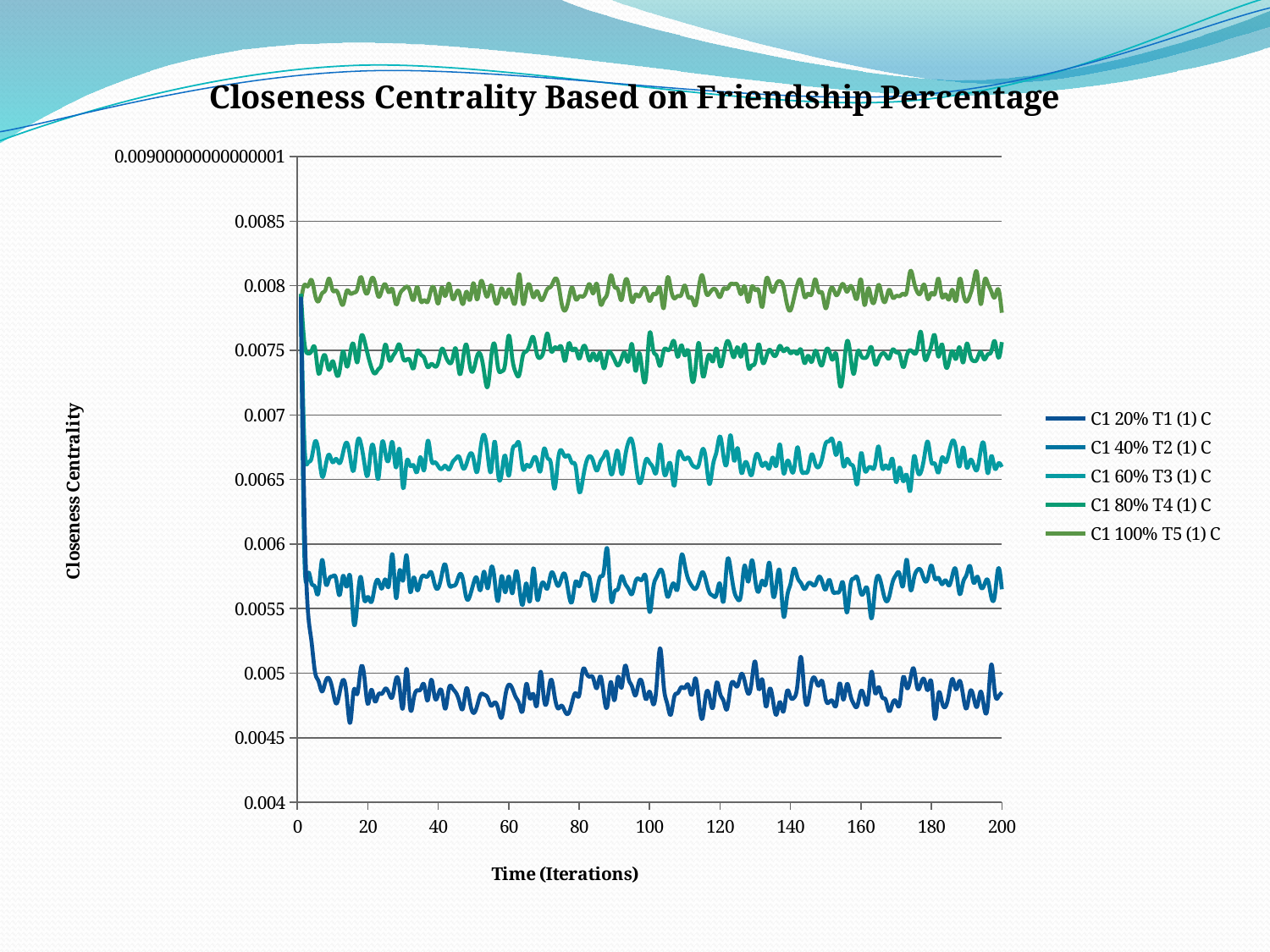
How many series does the legend list? 5 What is the label of the x axis? Time (Iterations) Are the values for C1 100% T5 (1) C greater or less than 0.0075? greater Which series has the highest closeness centrality values across the iterations? C1 100% T5 (1) C Are the values for C1 80% T4 (1) C greater or less than 0.007? greater What kind of chart is shown on the slide? Line chart Are the values for C1 60% T3 (1) C greater or less than 0.006? greater Which series has higher values, C1 60% T3 (1) C or C1 40% T2 (1) C? C1 60% T3 (1) C What is the title of the chart? Closeness Centrality Based on Friendship Percentage Which series has the lowest closeness centrality values across the iterations? C1 20% T1 (1) C